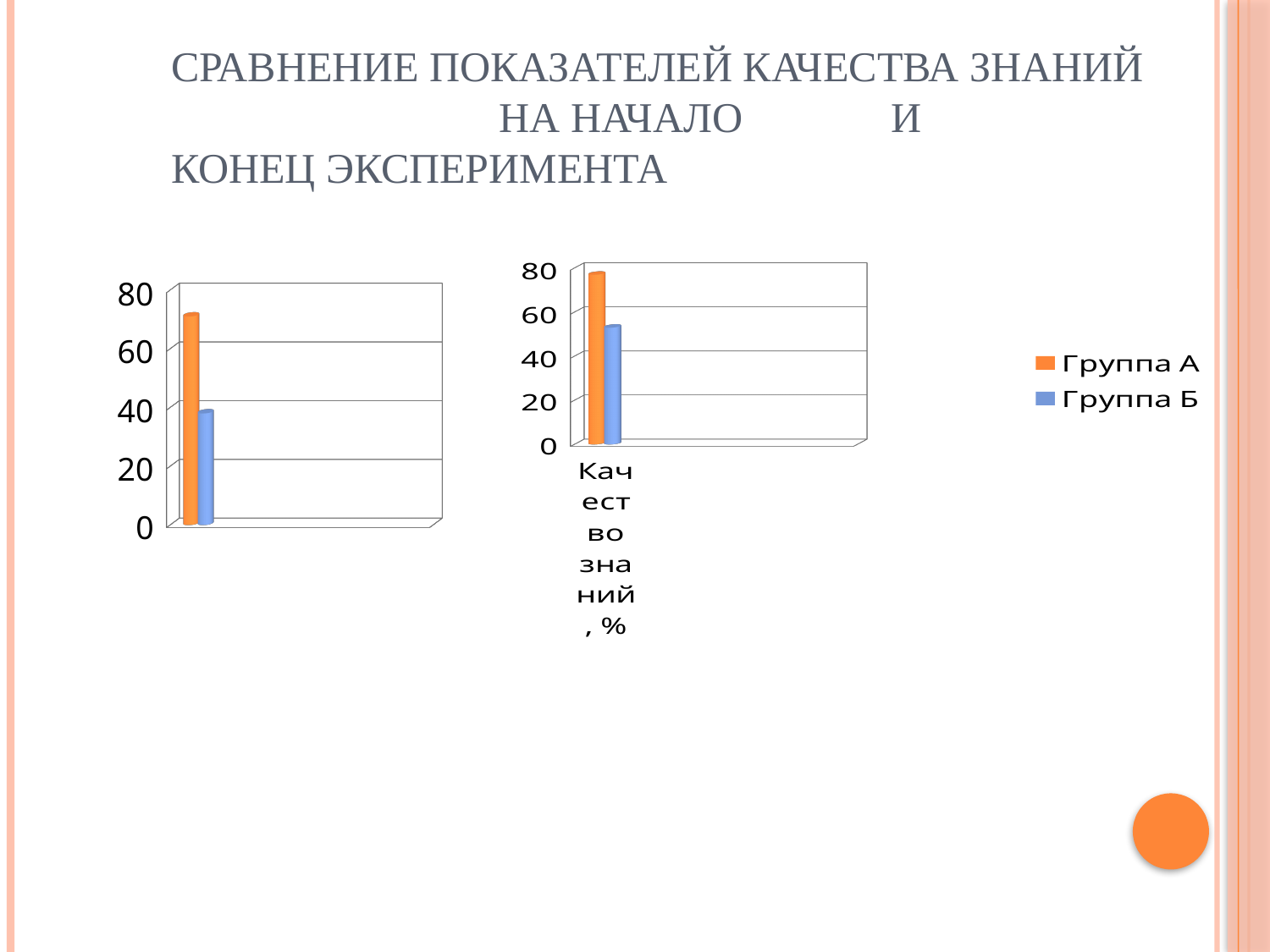
In the chart on the left, which bar is taller, the orange bar or the blue bar? the orange bar In the chart on the left, is the value of the orange bar greater or less than 60? greater In the chart on the right, what is the category label on the x axis? Качество знаний, % What kind of chart is the chart on the right of the slide? bar chart In the chart on the right, is the value for Группа Б greater or less than 60? less What kind of chart is the chart on the left of the slide? bar chart In the chart on the right, which series has the higher value, Группа А or Группа Б? Группа А What are the two series named in the legend? Группа А, Группа Б In the chart on the right, is the value for Группа Б greater or less than 40? greater How many series does the legend on the slide list? 2